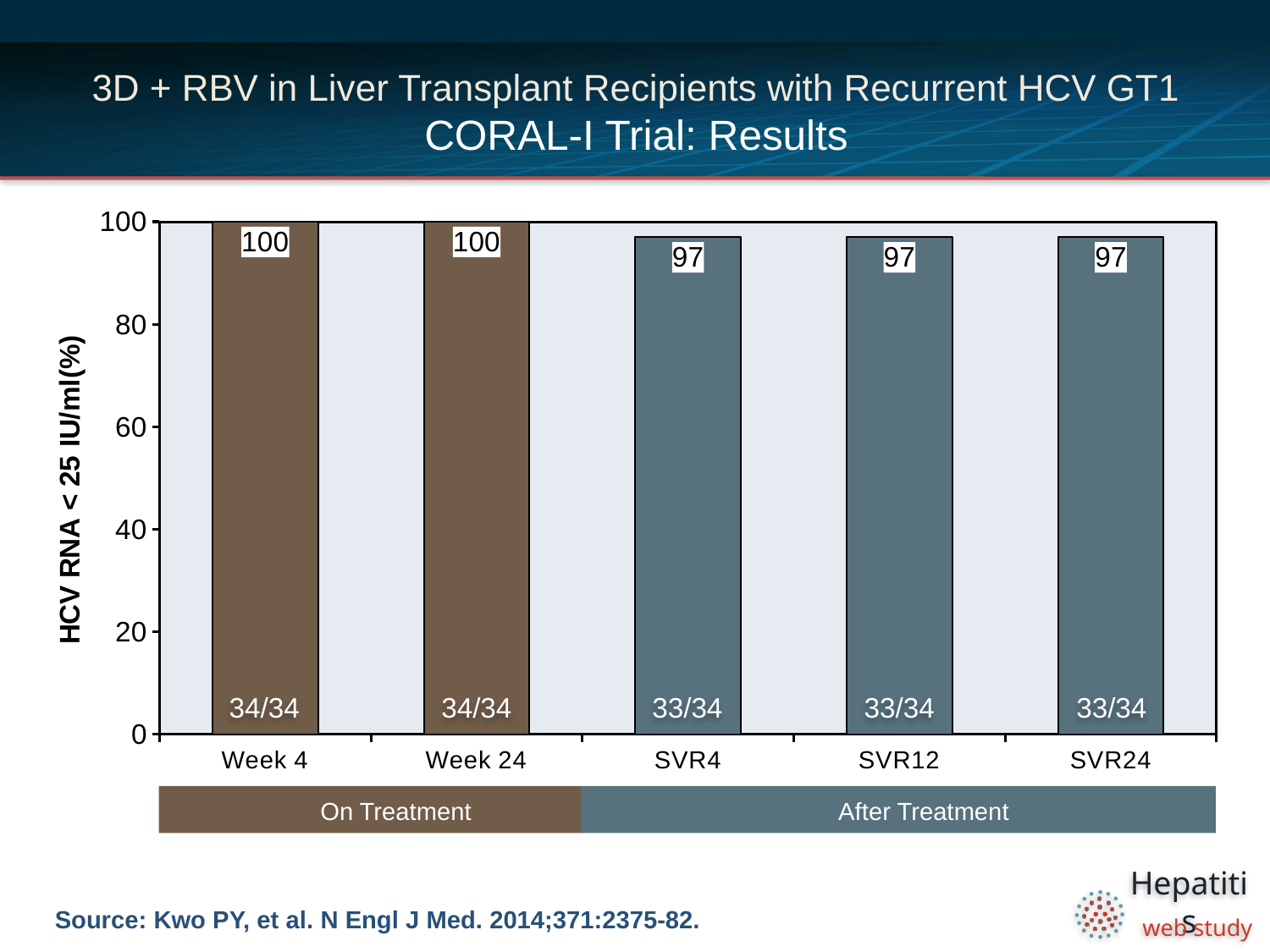
What is the label of the y axis? HCV RNA < 25 IU/ml(%) What is the value for SVR12? 97 Which time points are grouped under the 'On Treatment' label below the chart? Week 4 and Week 24 Is the value for SVR4 greater or less than 80? greater What kind of chart is shown on the slide? bar chart What is the value for Week 4? 100 What fraction of patients is shown inside the SVR4 bar? 33/34 How many categories are shown on the x axis? 5 Which is larger, the value for Week 4 or the value for SVR24? Week 4 What is the difference between the value for Week 24 and the value for SVR12? 3 What fraction of patients is shown inside the Week 24 bar? 34/34 What is the value for SVR24? 97